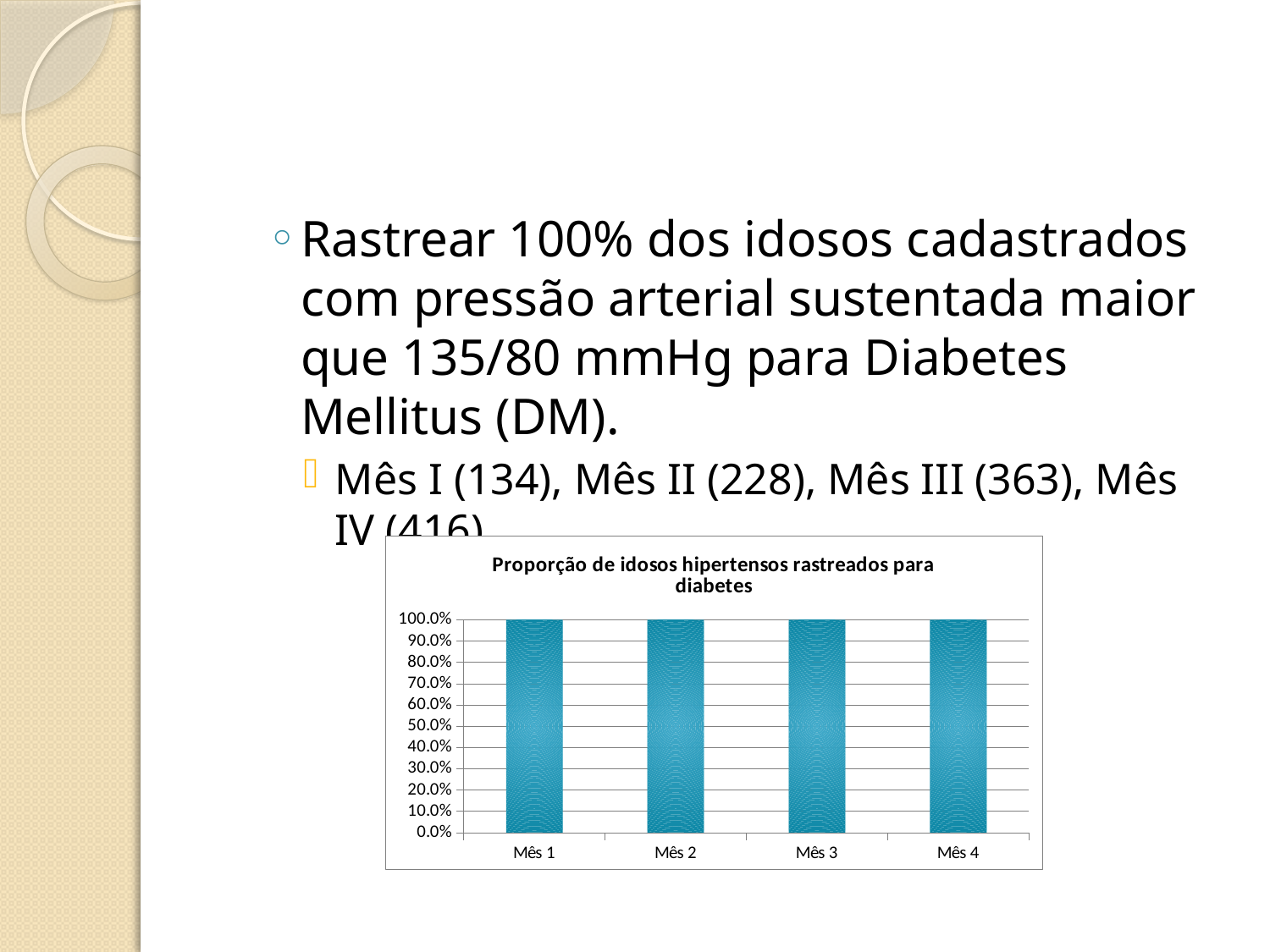
What is the title of the chart? Proporção de idosos hipertensos rastreados para diabetes What is the label of the first category on the x axis? Mês 1 What is the value for Mês 2? 100.0% Do the values rise, fall, or stay the same from Mês 1 to Mês 4? stay the same What is the difference between the values for Mês 4 and Mês 1? 0.0% What is the value for Mês 1? 100.0% What is the value for Mês 4? 100.0% What type of chart is shown on the slide? bar chart What is the value for Mês 3? 100.0% Is the value for Mês 1 greater or less than 90.0%? greater How many categories are shown on the x axis of the chart? 4 Is the value for Mês 3 greater or less than 50.0%? greater